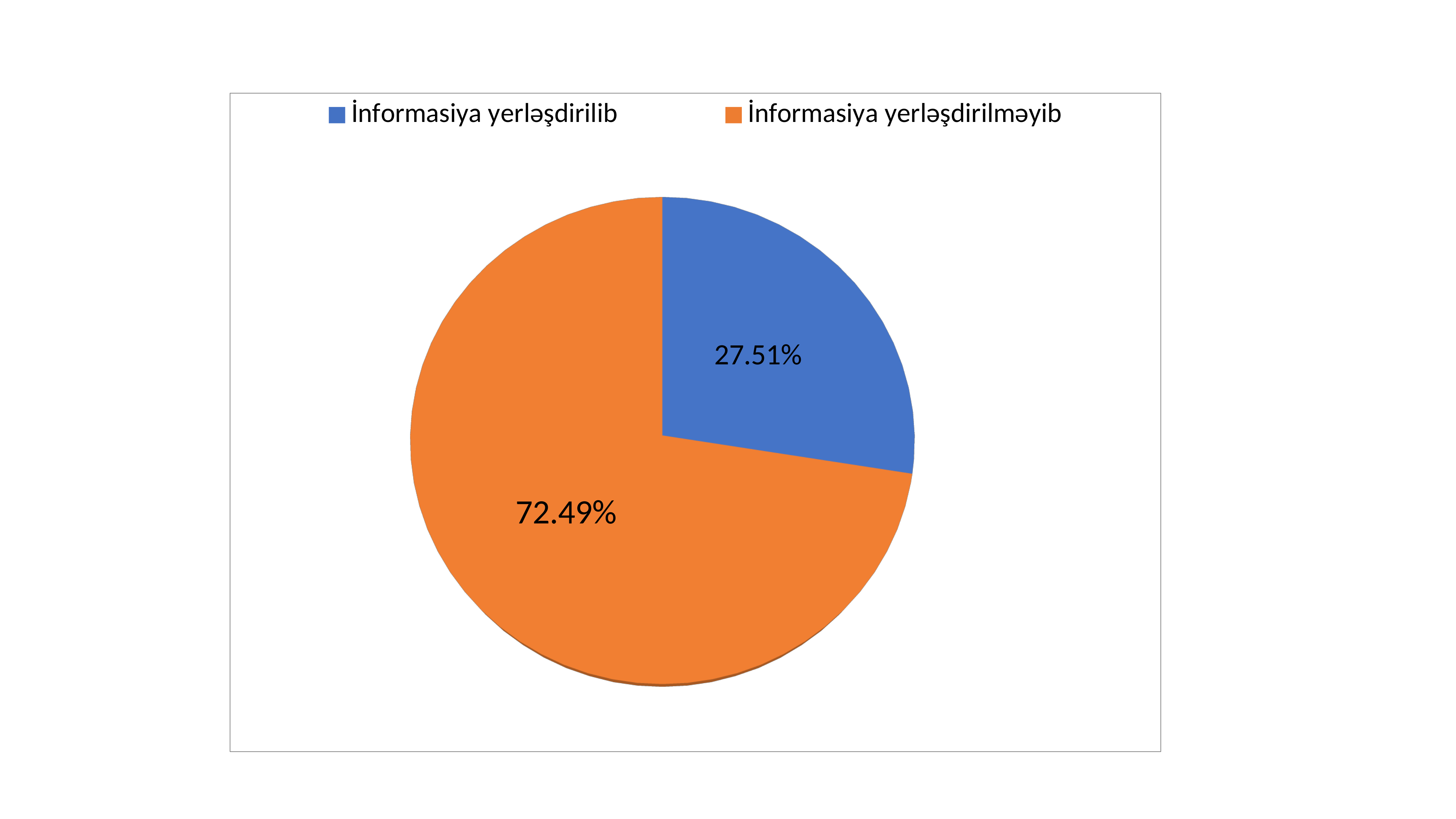
What is the difference in percentage points between "İnformasiya yerləşdirilməyib" and "İnformasiya yerləşdirilib"? 44.98 What colour is the slice for "İnformasiya yerləşdirilməyib"? orange Which slice is the largest? İnformasiya yerləşdirilməyib How many entries does the legend list? 2 How many slices does the pie chart have? 2 Which slice is the smallest? İnformasiya yerləşdirilib What share of the pie does "İnformasiya yerləşdirilib" represent? 27.51% What kind of chart is shown on the slide? pie chart What share of the pie does "İnformasiya yerləşdirilməyib" represent? 72.49% What colour is the slice for "İnformasiya yerləşdirilib"? blue Which is larger: the share for "İnformasiya yerləşdirilib" or the share for "İnformasiya yerləşdirilməyib"? İnformasiya yerləşdirilməyib